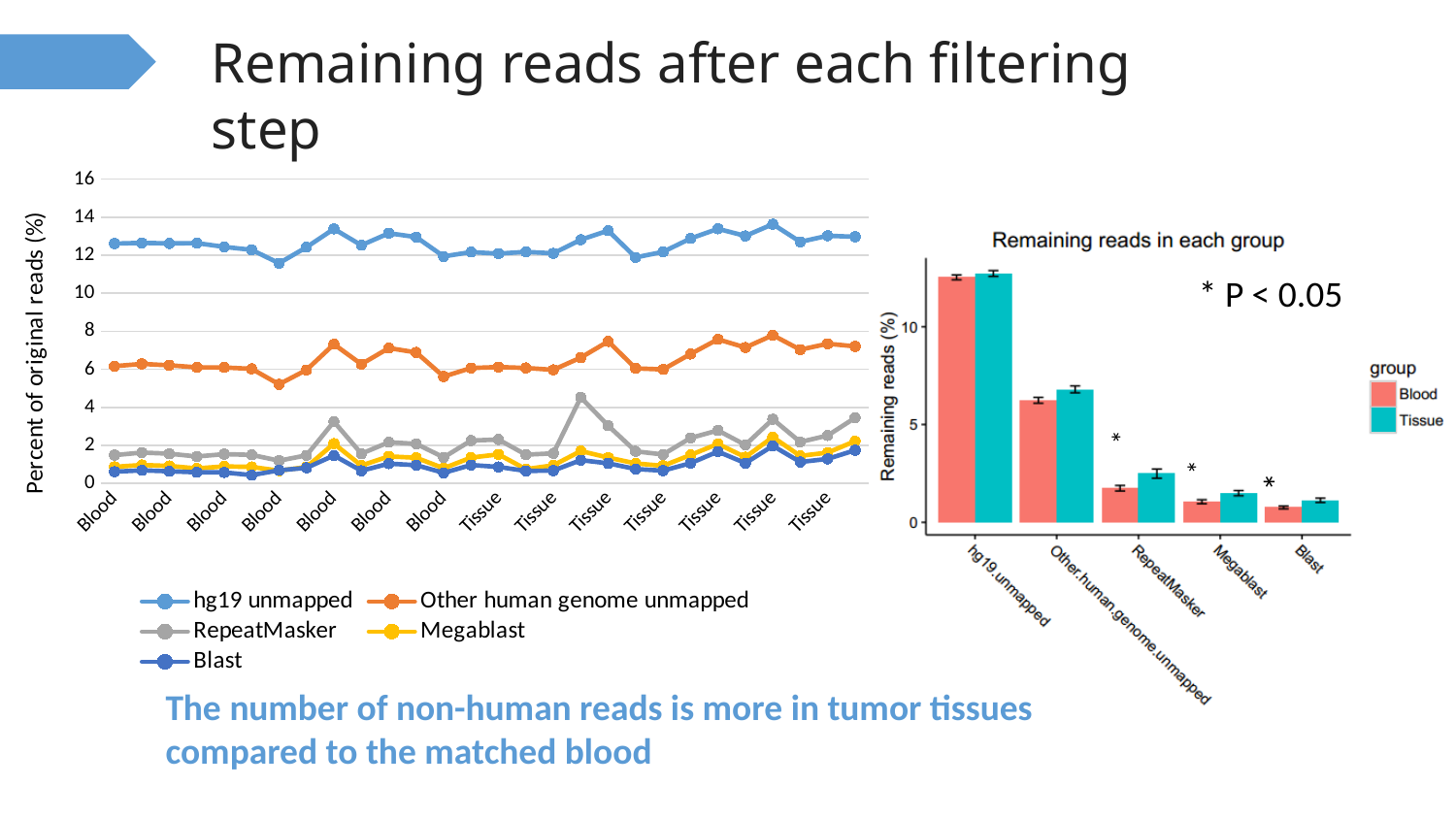
What kind of chart is the chart titled "Remaining reads in each group"? bar chart In the chart titled "Remaining reads in each group", how many categories are shown on the x axis? 5 In the chart titled "Remaining reads in each group", is the Blood value for hg19.unmapped greater or less than 10? greater In the line chart on the left, are the values of the "Other human genome unmapped" series greater or less than 10? less In the chart titled "Remaining reads in each group", for RepeatMasker, which group has the larger value, Blood or Tissue? Tissue In the chart titled "Remaining reads in each group", how many groups does the legend list? 2 In the line chart on the left, how many series does the legend list? 5 In the chart titled "Remaining reads in each group", which category has the lowest remaining reads? Blast In the chart titled "Remaining reads in each group", which category has the highest remaining reads? hg19.unmapped What kind of chart is the chart on the left of the slide? line chart In the line chart on the left, which series has the highest values across all samples? hg19 unmapped In the chart titled "Remaining reads in each group", is the Tissue value for RepeatMasker greater or less than 5? less